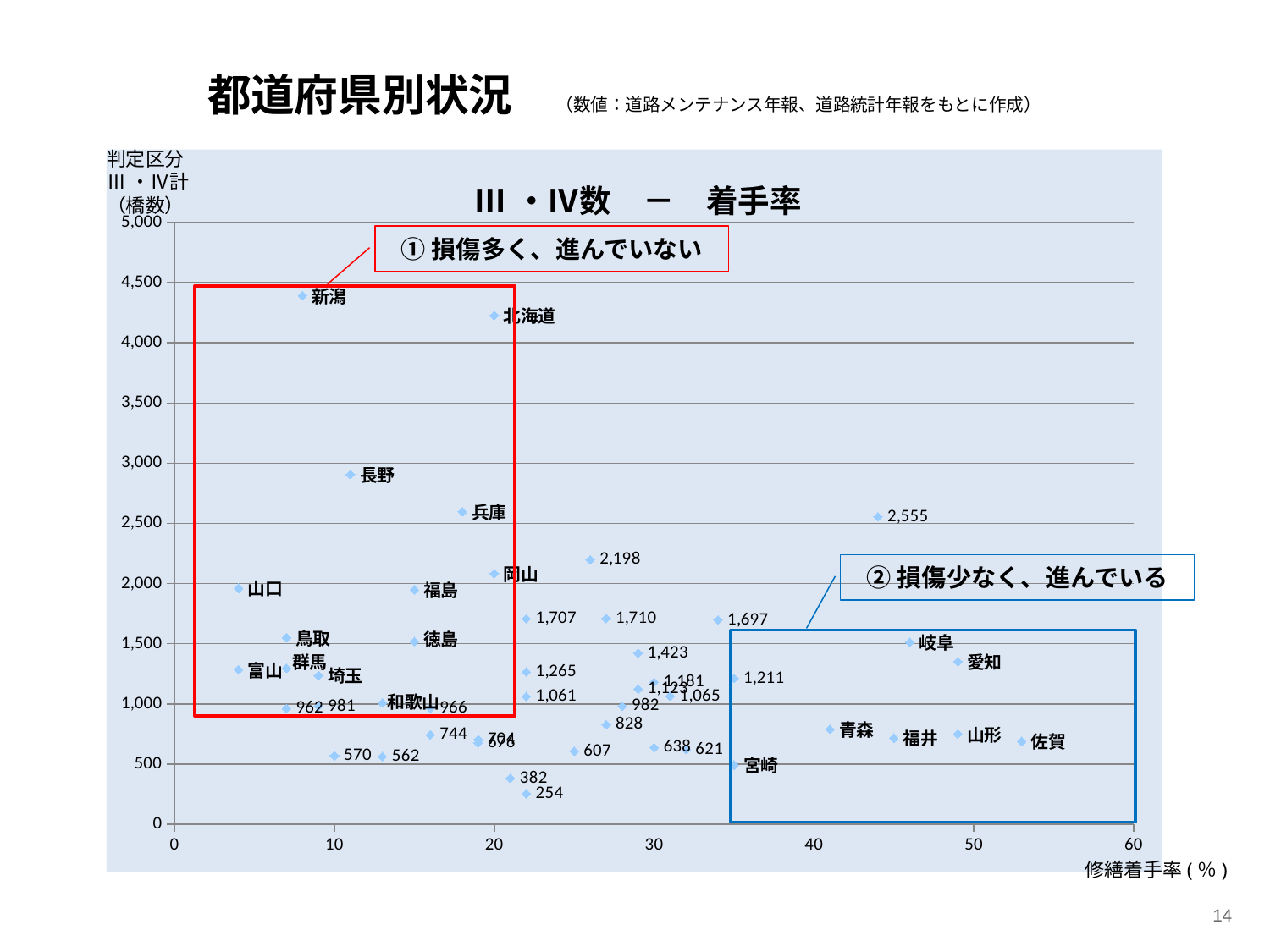
Is the vertical-axis value for 北海道 greater or less than 4,000? greater What is the title of the chart? Ⅲ・Ⅳ数 － 着手率 What is the difference between the data labels 2,555 and 2,198? 357 Which has the higher vertical-axis value, 長野 or 兵庫? 長野 What is the label of the x axis of the chart? 修繕着手率(%) What kind of chart is shown on the slide? scatter chart Is the vertical-axis value for 宮崎 greater or less than 1,000? less Which named prefecture has the highest value on the vertical axis? 新潟 Is the vertical-axis value for 愛知 greater or less than 1,000? greater How many prefecture names are shown inside the blue box labelled ② 損傷少なく、進んでいる? 7 What is the largest numeric data label printed on the chart? 2,555 What is the smallest numeric data label printed on the chart? 254